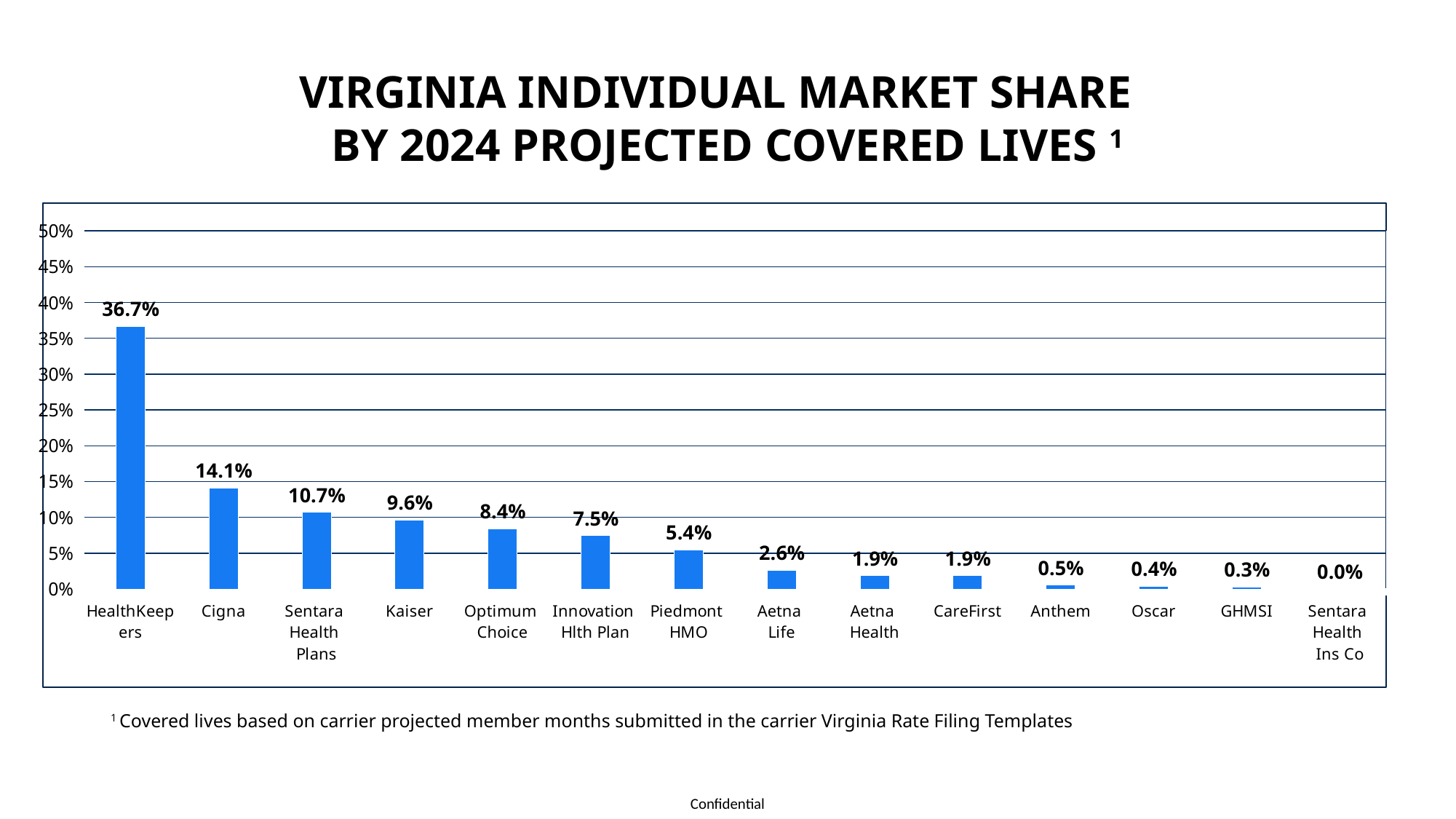
What is the title of the chart? Virginia Individual Market Share by 2024 Projected Covered Lives Which carrier has the highest market share? HealthKeepers What is the difference in market share between Optimum Choice and Innovation Hlth Plan? 0.9% What is the market share for Piedmont HMO? 5.4% What kind of chart is shown on the slide? Bar chart What is the difference in market share between HealthKeepers and Cigna? 22.6% How many carriers are shown on the chart? 14 What is the market share for Cigna? 14.1% Which has a larger market share, Sentara Health Plans or Kaiser? Sentara Health Plans Is the value for HealthKeepers greater or less than 35%? greater What is the market share for Kaiser? 9.6% Which carrier has the lowest market share? Sentara Health Ins Co